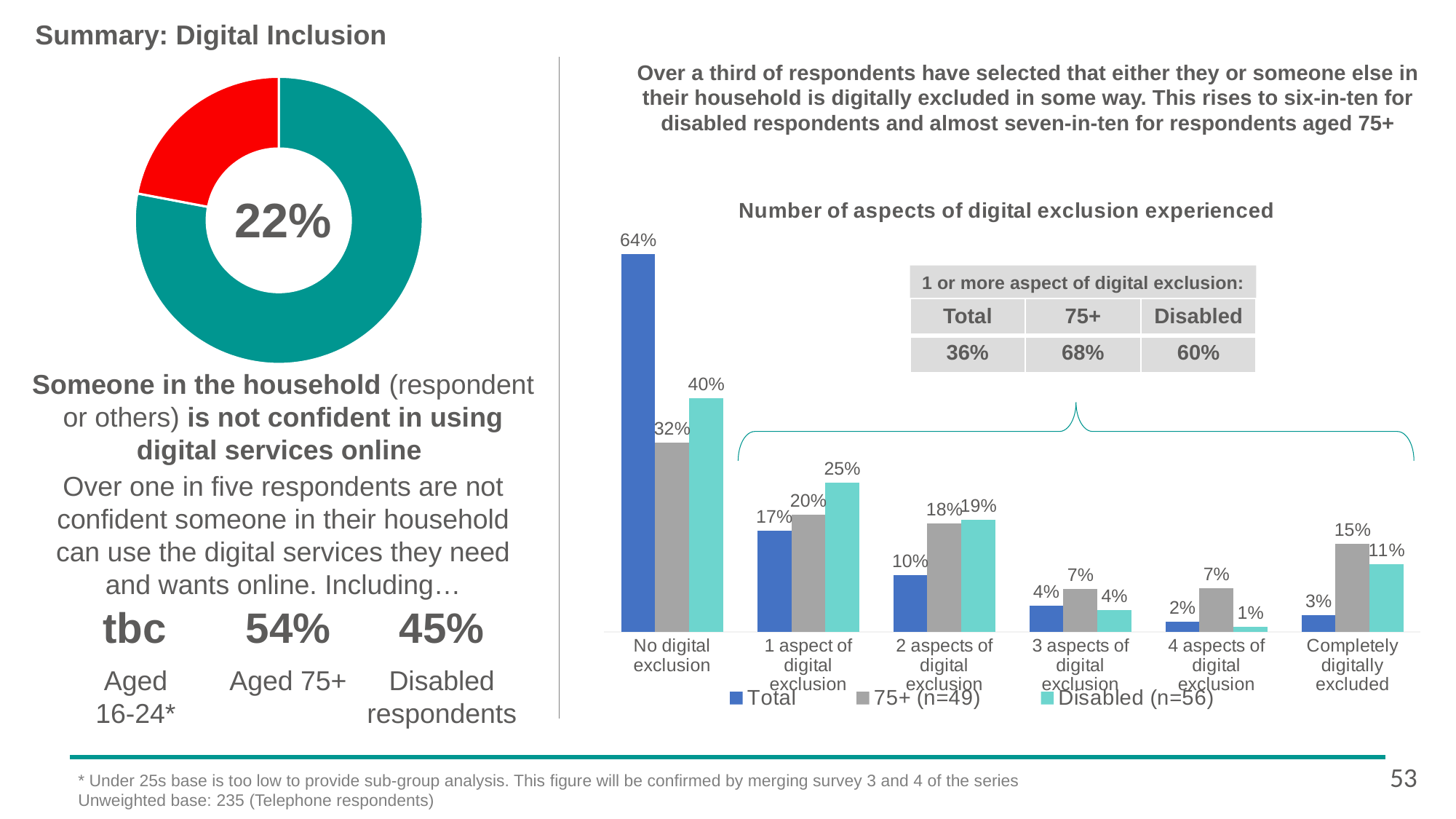
How many categories are shown on the x axis of the bar chart 'Number of aspects of digital exclusion experienced'? 6 What kind of chart is shown on the left of the slide with the 22% label? Donut chart In the bar chart 'Number of aspects of digital exclusion experienced', which category has the highest Total value? No digital exclusion What share of the donut chart on the left of the slide does the red slice represent? 22% In the bar chart 'Number of aspects of digital exclusion experienced', what is the difference between the Total and 75+ (n=49) values for 'No digital exclusion'? 32% In the bar chart 'Number of aspects of digital exclusion experienced', what is the Disabled (n=56) value for '1 aspect of digital exclusion'? 25% What kind of chart is the chart titled 'Number of aspects of digital exclusion experienced'? Bar chart In the bar chart 'Number of aspects of digital exclusion experienced', which category has the lowest Disabled (n=56) value? 4 aspects of digital exclusion In the bar chart 'Number of aspects of digital exclusion experienced', what is the value for 75+ (n=49) in the 'Completely digitally excluded' category? 15% In the bar chart 'Number of aspects of digital exclusion experienced', what is the Total value for 'No digital exclusion'? 64% How many series does the legend of the bar chart 'Number of aspects of digital exclusion experienced' list? 3 In the bar chart 'Number of aspects of digital exclusion experienced', which is larger for '2 aspects of digital exclusion': the Total value or the 75+ (n=49) value? 75+ (n=49)